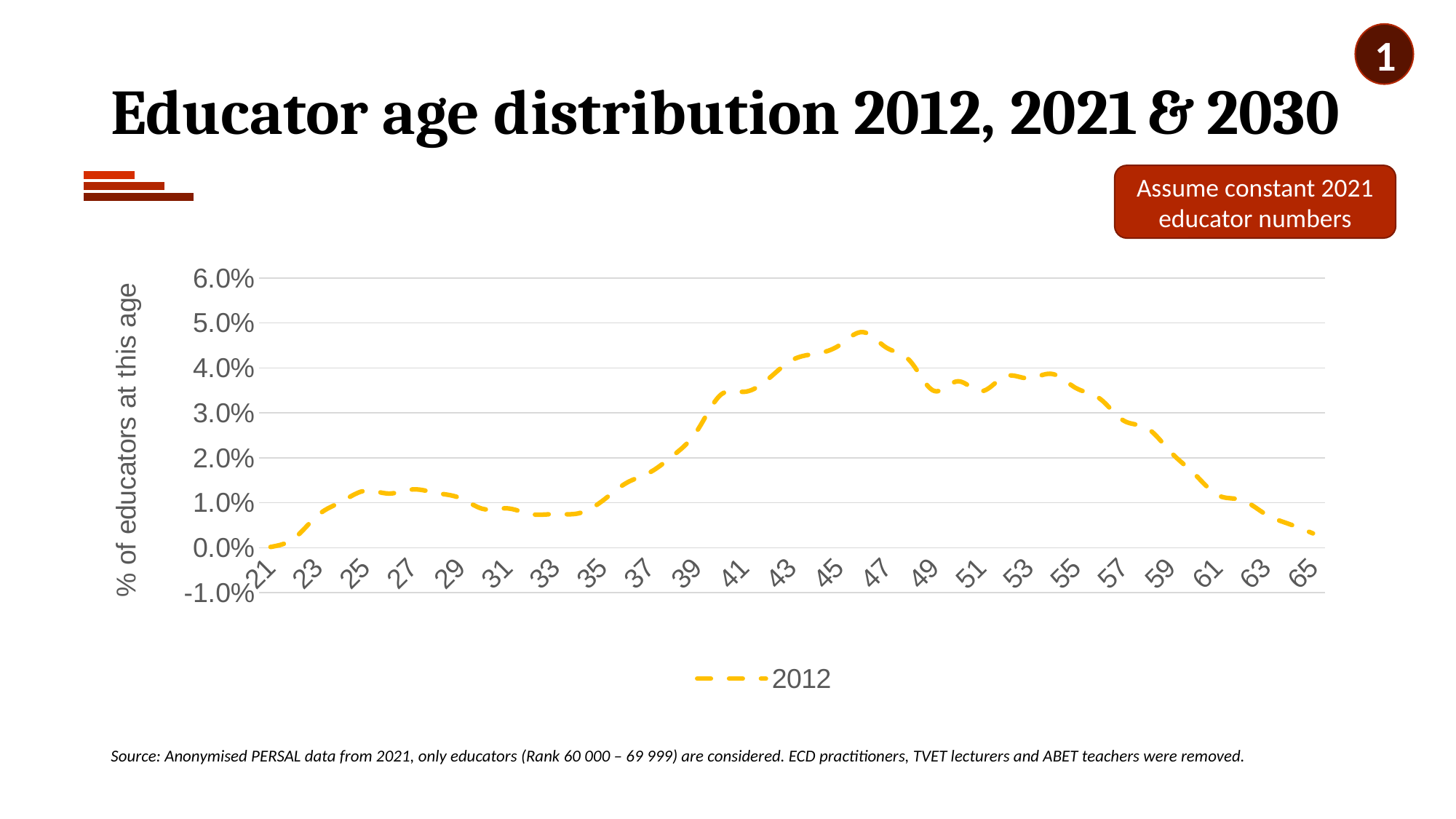
Is the value for age 47 greater or less than 4.0%? greater Is the value for age 59 greater or less than 3.0%? less Does the line rise or fall between age 47 and age 65? fall Which has the larger value, age 27 or age 47? 47 What series name appears in the legend? 2012 Is the value for age 65 greater or less than 1.0%? less How many series does the legend list? 1 What kind of chart is shown on the slide? line chart What is the label on the vertical axis? % of educators at this age How many age labels are shown along the x axis? 23